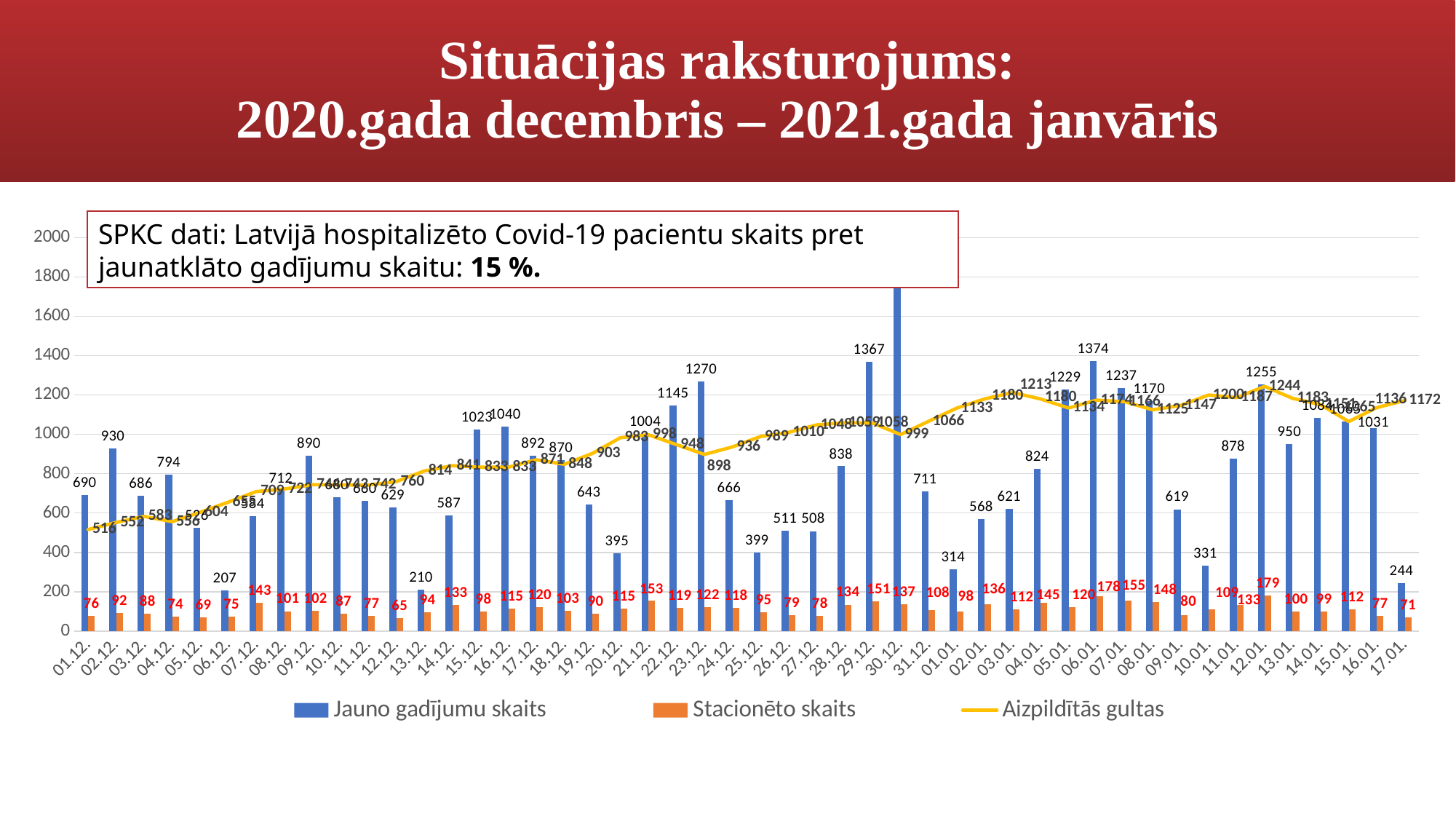
What is the value of Stacionēto skaits on 17.01.? 71 Which date has a higher Jauno gadījumu skaits, 05.01. or 06.01.? 06.01. On which date is Stacionēto skaits the lowest? 12.12. What is the value of Jauno gadījumu skaits on 29.12.? 1367 What is the difference between Jauno gadījumu skaits on 23.12. and on 24.12.? 604 What kind of chart is shown on the slide? Combination bar and line chart How many series does the legend list? 3 What is the value of Jauno gadījumu skaits on 02.12.? 930 Does the Aizpildītās gultas line generally rise or fall from 01.12. to 17.01.? Rise What is the value of Stacionēto skaits on 06.01.? 178 Is the value of Jauno gadījumu skaits on 30.12. greater or less than 1600? greater How many dates are shown on the x axis? 48